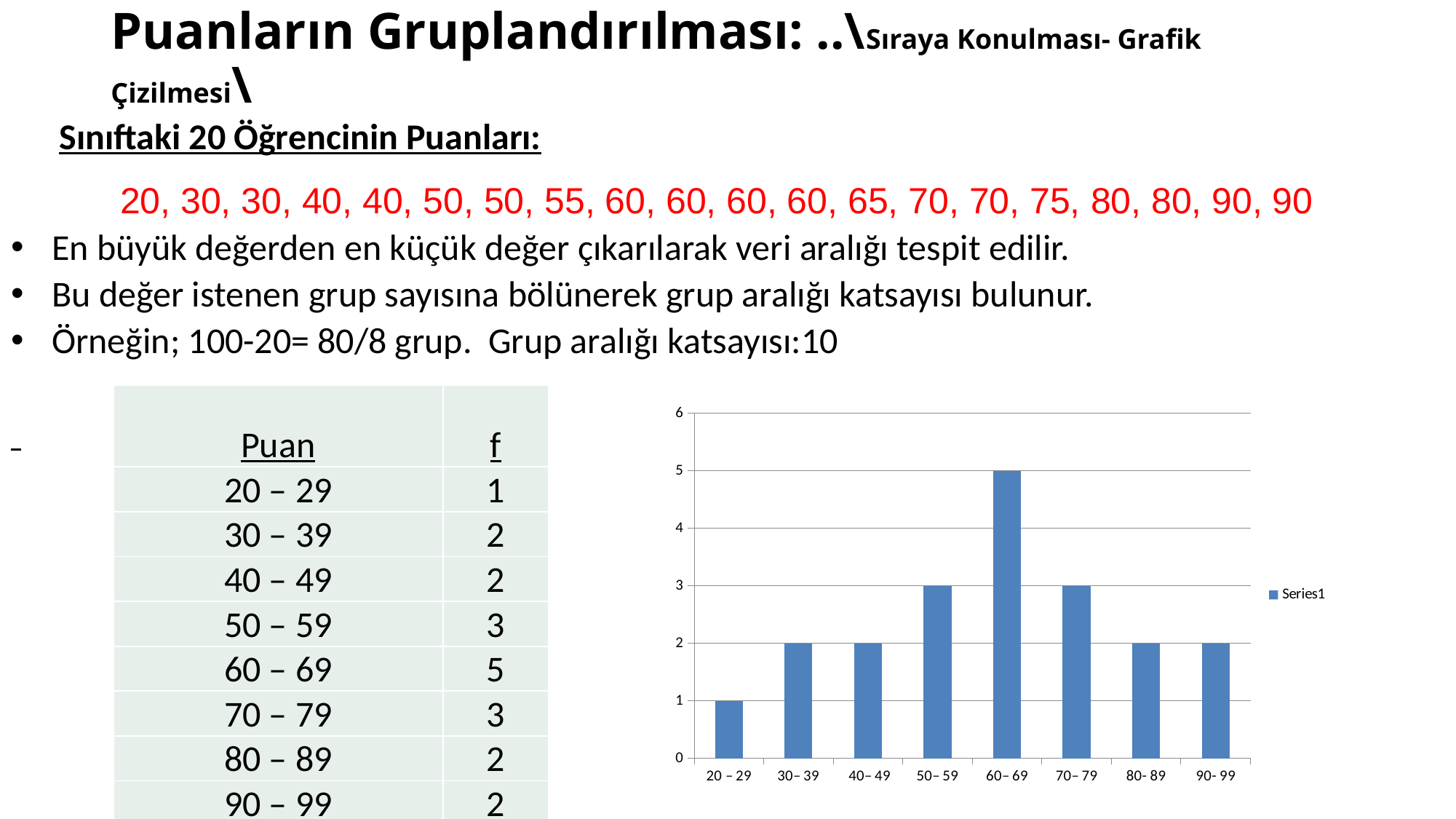
What is the value of the bar for the 60 – 69 group? 5 What is the value of the bar for the 50 – 59 group? 3 How many categories (score groups) are shown on the x axis of the chart? 8 How many series does the chart legend list? 1 Which score group has the highest bar in the chart? 60 – 69 What is the value of the bar for the 20 – 29 group? 1 What type of chart is shown on the slide? bar chart Which score group has the lowest bar in the chart? 20 – 29 Which bar is taller, 50 – 59 or 80 – 89? 50 – 59 Is the value for the 60 – 69 group greater or less than 4? greater What is the difference between the bar for 60 – 69 and the bar for 70 – 79? 2 What is the name of the series shown in the chart legend? Series1